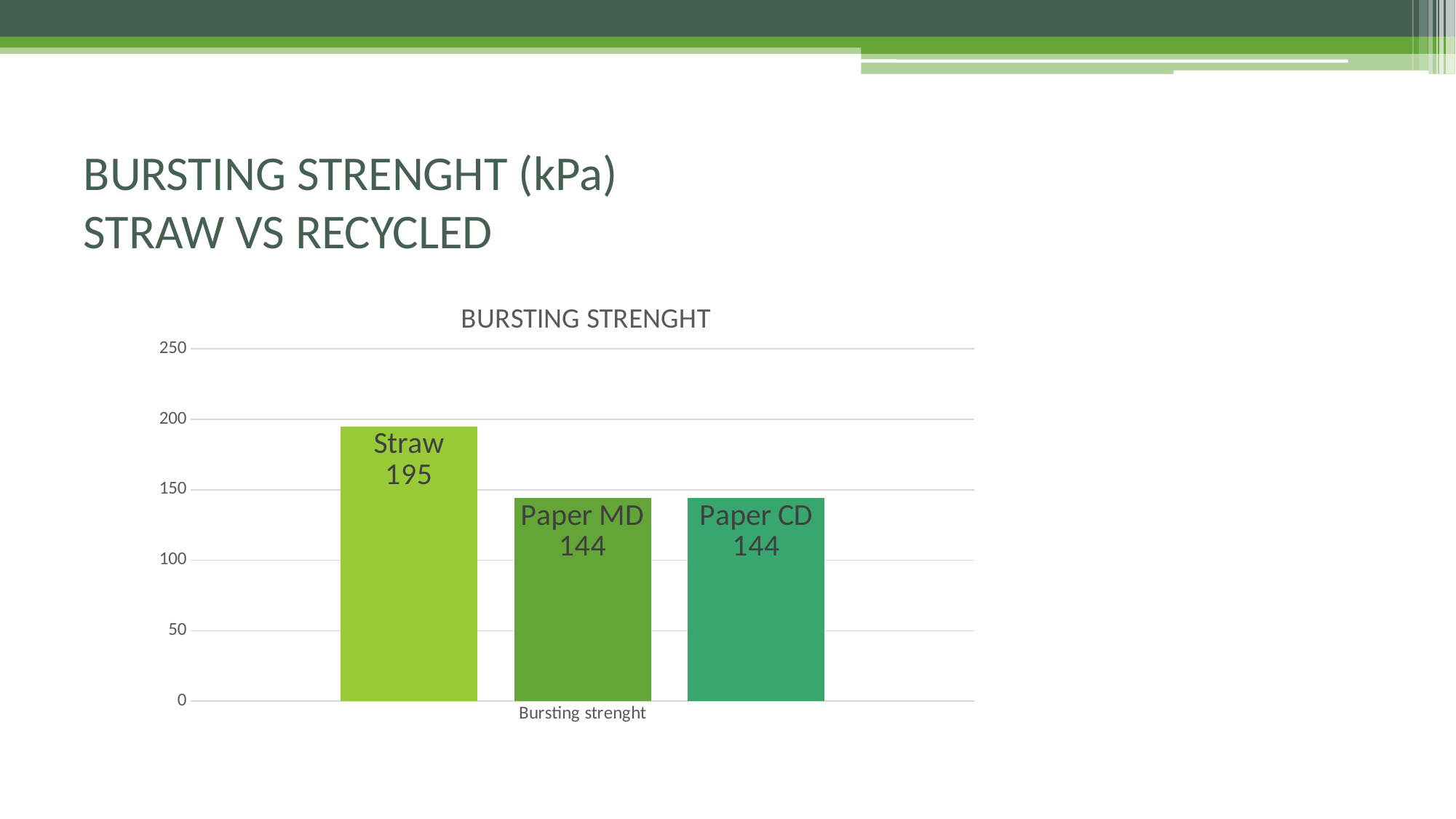
What is the bursting strength value for Paper MD? 144 Which bar has the highest bursting strength? Straw How many bars are shown in the chart? 3 What is the difference between the Straw value and the Paper MD value? 51 What is the highest value shown on the vertical axis? 250 What is the bursting strength value for Straw? 195 What is the bursting strength value for Paper CD? 144 Is the value for Paper MD greater or less than 150? less Is the value for Straw greater or less than 150? greater Which is larger, the value for Straw or the value for Paper CD? Straw What type of chart is shown on the slide? Bar chart What is the title of the chart? BURSTING STRENGHT